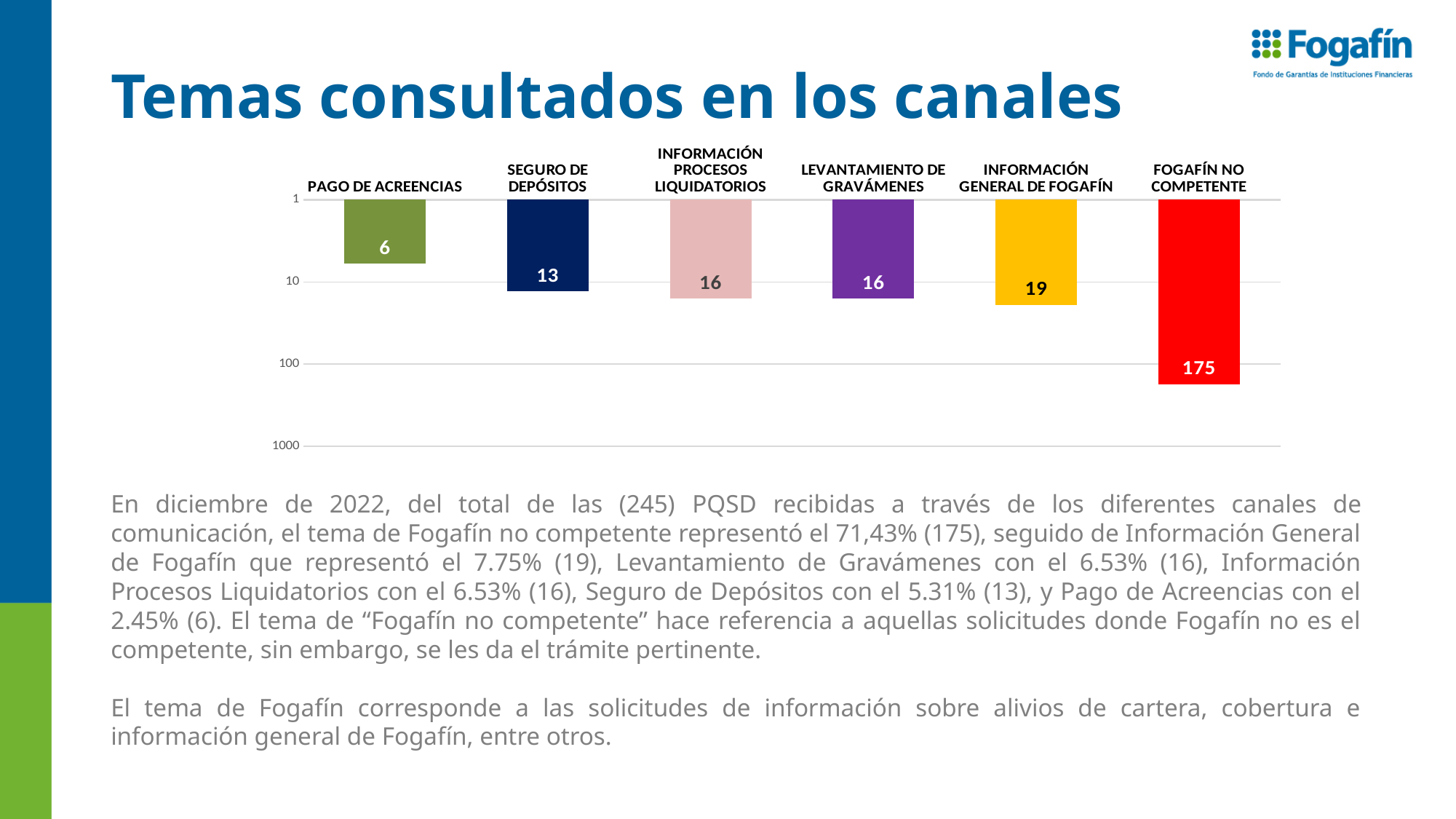
What kind of chart is shown on the slide? Bar chart What is the value for SEGURO DE DEPÓSITOS? 13 Which category has the lowest value? PAGO DE ACREENCIAS What is the difference between the values for FOGAFÍN NO COMPETENTE and INFORMACIÓN GENERAL DE FOGAFÍN? 156 What colour is the bar for FOGAFÍN NO COMPETENTE? Red What is the value for INFORMACIÓN GENERAL DE FOGAFÍN? 19 What is the value for FOGAFÍN NO COMPETENTE? 175 Which is larger, the value for LEVANTAMIENTO DE GRAVÁMENES or the value for SEGURO DE DEPÓSITOS? LEVANTAMIENTO DE GRAVÁMENES How many categories are shown in the chart? 6 Which category has the highest value? FOGAFÍN NO COMPETENTE What is the value for PAGO DE ACREENCIAS? 6 What is the difference between the values for SEGURO DE DEPÓSITOS and PAGO DE ACREENCIAS? 7